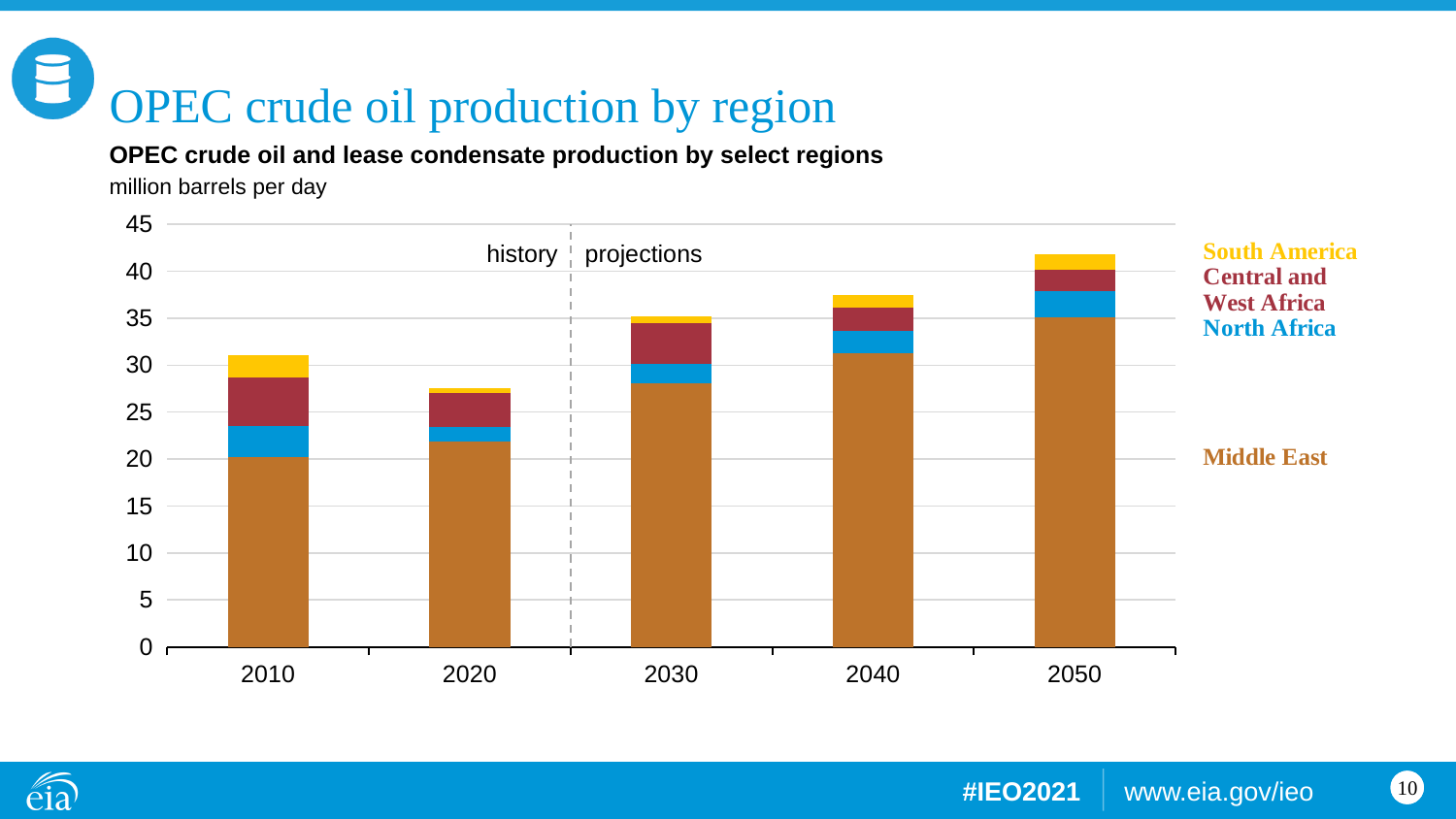
How many regions does the chart's legend list? 4 Between 2020 and 2050, do the total production bars rise or fall? rise Is the Middle East value for 2010 greater or less than 25 million barrels per day? less Which year has the larger total bar, 2010 or 2020? 2010 What kind of chart is shown on the slide? Stacked bar chart Is the total bar for 2050 greater or less than 40 million barrels per day? greater Which year has the lowest total OPEC crude oil production bar? 2020 What unit is the chart's y axis measured in? million barrels per day Which year has the highest total OPEC crude oil production bar? 2050 Is the Middle East value for 2050 greater or less than 30 million barrels per day? greater How many years are shown along the x axis of the chart? 5